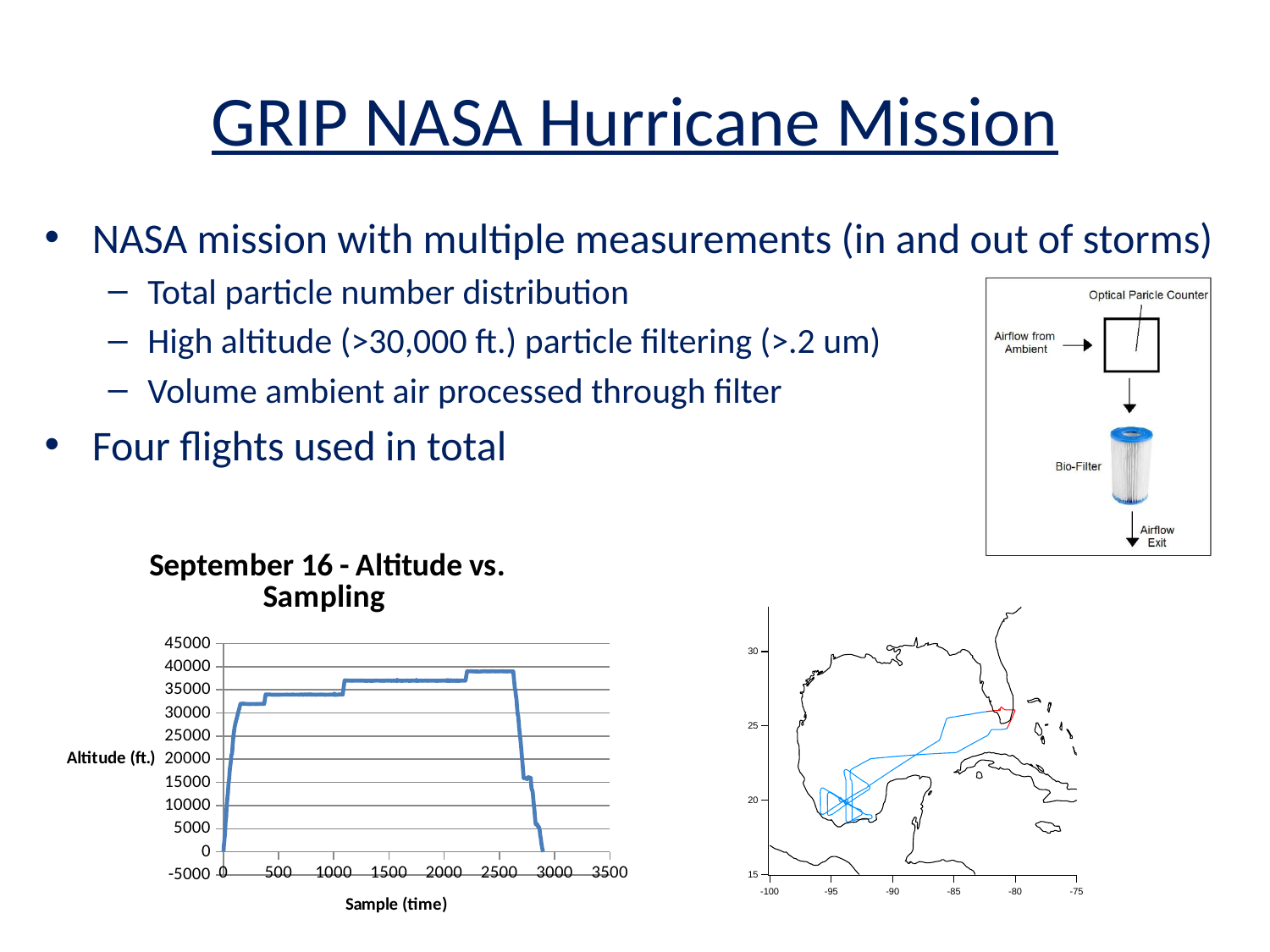
In the 'September 16 - Altitude vs. Sampling' chart, does the altitude rise or fall between sample 0 and sample 500? rise What kind of chart is the 'September 16 - Altitude vs. Sampling' chart? line chart What is the title of the chart in the lower left of the slide? September 16 - Altitude vs. Sampling In the 'September 16 - Altitude vs. Sampling' chart, is the altitude at sample 2500 greater or less than 35000? greater In the 'September 16 - Altitude vs. Sampling' chart, is the altitude at sample 2500 larger or smaller than the altitude at sample 500? larger In the 'September 16 - Altitude vs. Sampling' chart, is the altitude at sample 500 greater or less than 30000? greater In the 'September 16 - Altitude vs. Sampling' chart, does the altitude rise or fall between sample 2600 and sample 2900? fall In the 'September 16 - Altitude vs. Sampling' chart, is the altitude at sample 1500 greater or less than 35000? greater In the 'September 16 - Altitude vs. Sampling' chart, what is the highest value shown on the vertical axis? 45000 In the 'September 16 - Altitude vs. Sampling' chart, what is the label of the vertical axis? Altitude (ft.)